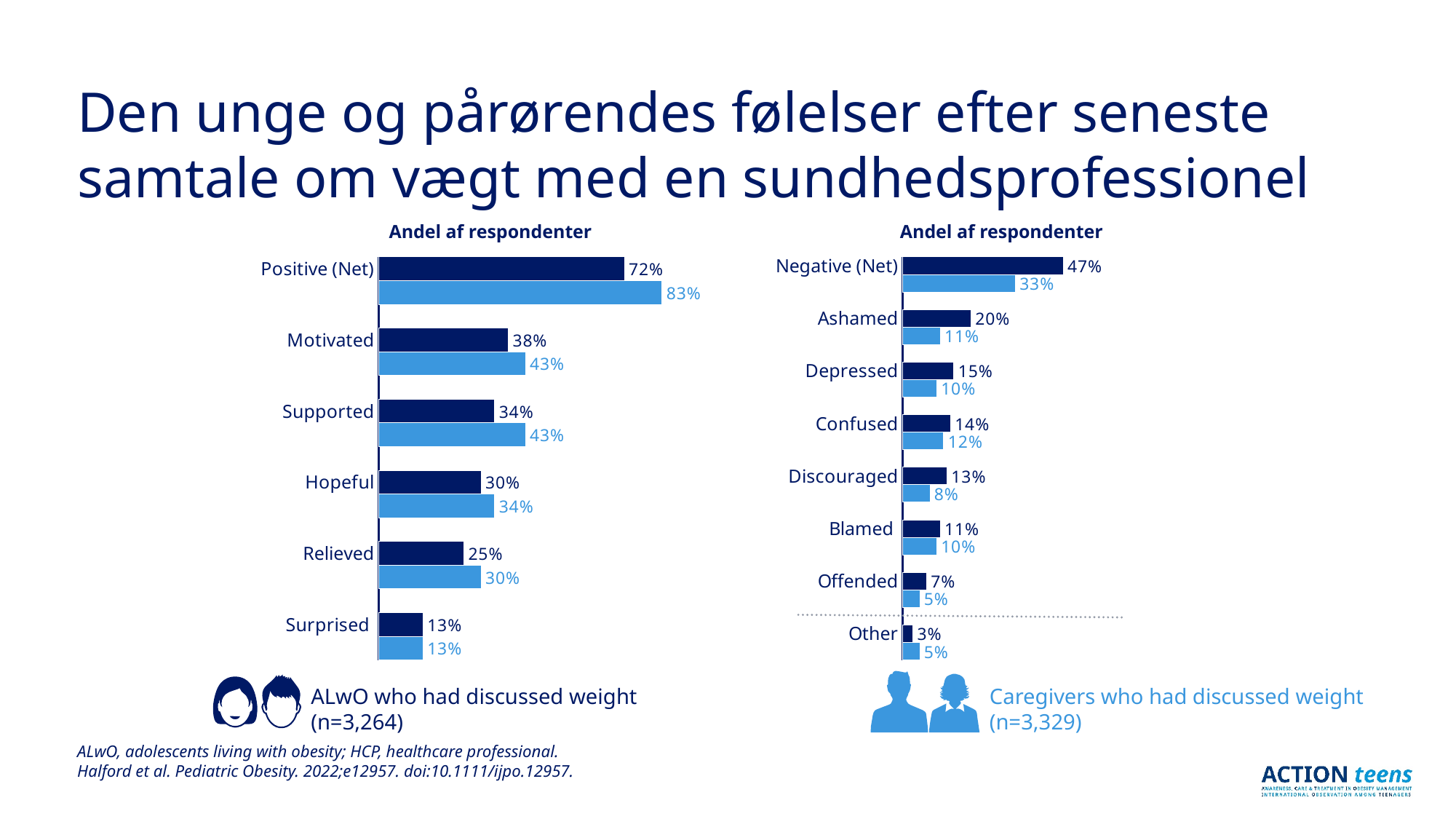
How many categories are shown in the right chart? 8 What type of chart is the left chart? Bar chart In the right chart, what is the difference between the ALwO and Caregivers values for Negative (Net)? 14% In the left chart, what is the difference between the Caregivers and ALwO values for Supported? 9% In the left chart, what is the value for Caregivers who had discussed weight for Positive (Net)? 83% In the left chart, which category has the lowest value for ALwO who had discussed weight? Surprised In the right chart, what is the value for Caregivers who had discussed weight for Discouraged? 8% In the right chart, which is larger for Other: the ALwO value or the Caregivers value? Caregivers In the left chart, what percentage of ALwO who had discussed weight reported feeling Motivated? 38% What is the sample size (n) for Caregivers who had discussed weight shown on the slide? n=3,329 In the right chart, which category has the highest value for Caregivers who had discussed weight? Negative (Net) In the right chart, what percentage of ALwO who had discussed weight reported feeling Ashamed? 20%